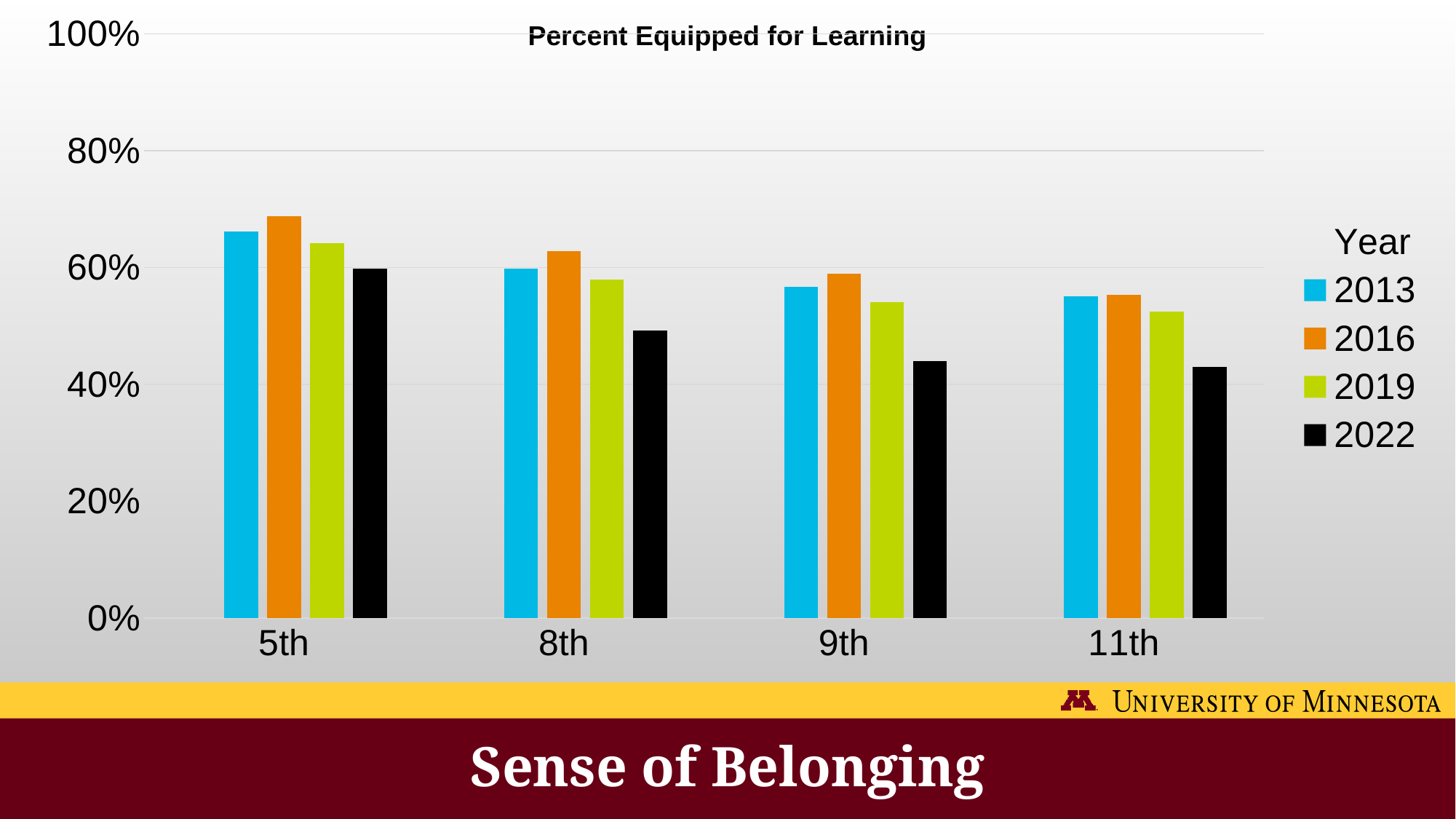
What kind of chart is shown on the slide? bar chart Is the value for 2022 in 8th grade greater or less than 60%? less Which colour represents 2022 in the chart? black How many years does the legend list? 4 How many grade categories are shown on the x axis? 4 Do the 2022 values rise or fall from 5th grade to 11th grade? fall For 5th grade, which year has the lowest bar? 2022 For 5th grade, which year has the highest bar? 2016 For 8th grade, which is larger, the value for 2013 or the value for 2022? 2013 Is the value for 2016 in 5th grade greater or less than 60%? greater What is the title of the chart? Percent Equipped for Learning Which grade has the highest value for 2022? 5th